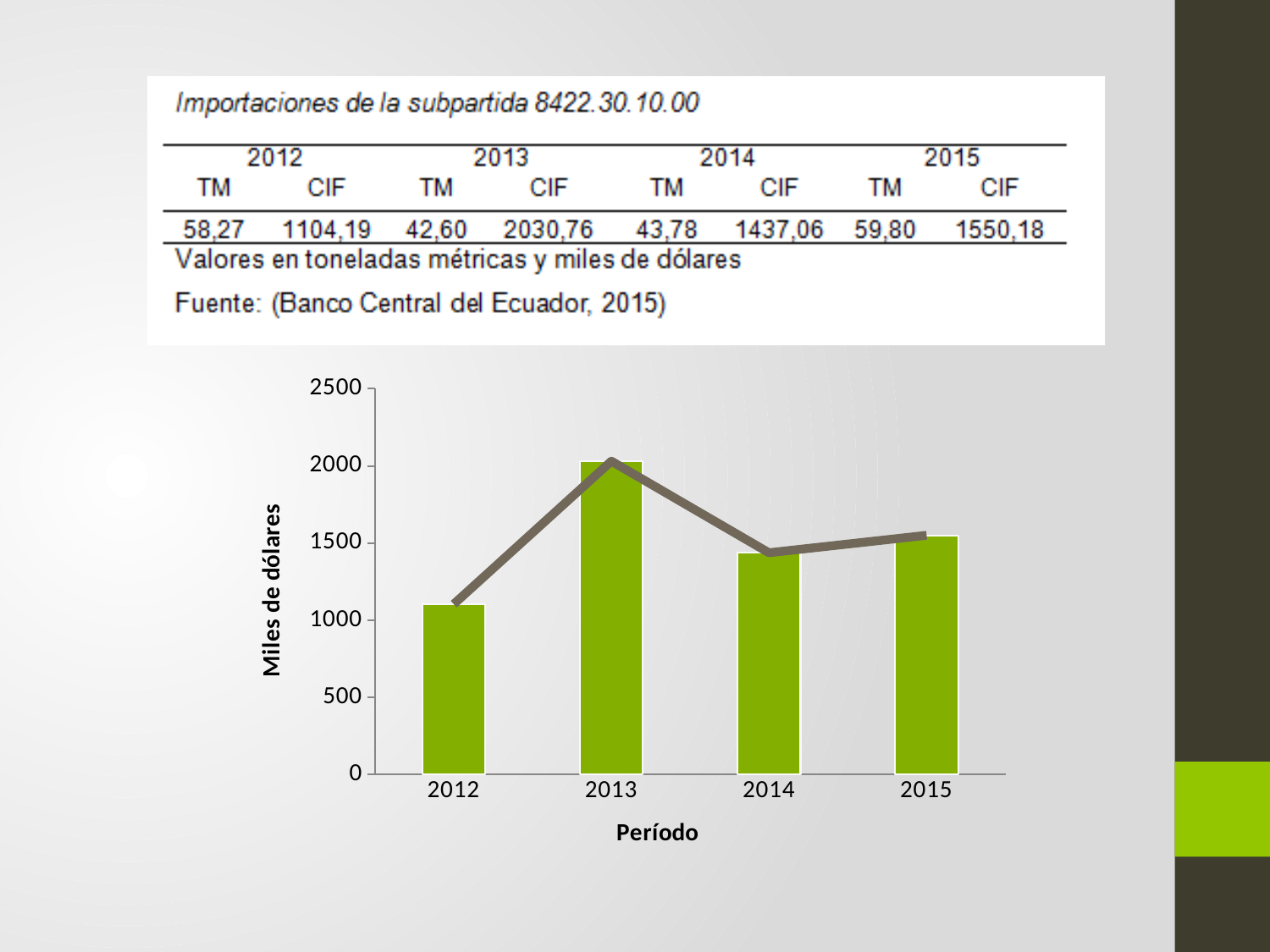
Does the value rise or fall from 2013 to 2014? fall Does the value rise or fall from 2012 to 2013? rise Is the value for 2014 greater or less than 2000? less Which year has the larger value in the chart, 2013 or 2014? 2013 How many periods (years) are shown on the x axis of the chart? 4 Which year has the larger value in the chart, 2012 or 2015? 2015 Is the value for 2012 greater or less than 1500? less Which year has the highest bar in the chart? 2013 Which year has the lowest bar in the chart? 2012 What is the title of the vertical axis of the chart? Miles de dólares What kind of chart is shown on the slide? combination bar and line chart Is the value for 2013 greater or less than 1500? greater